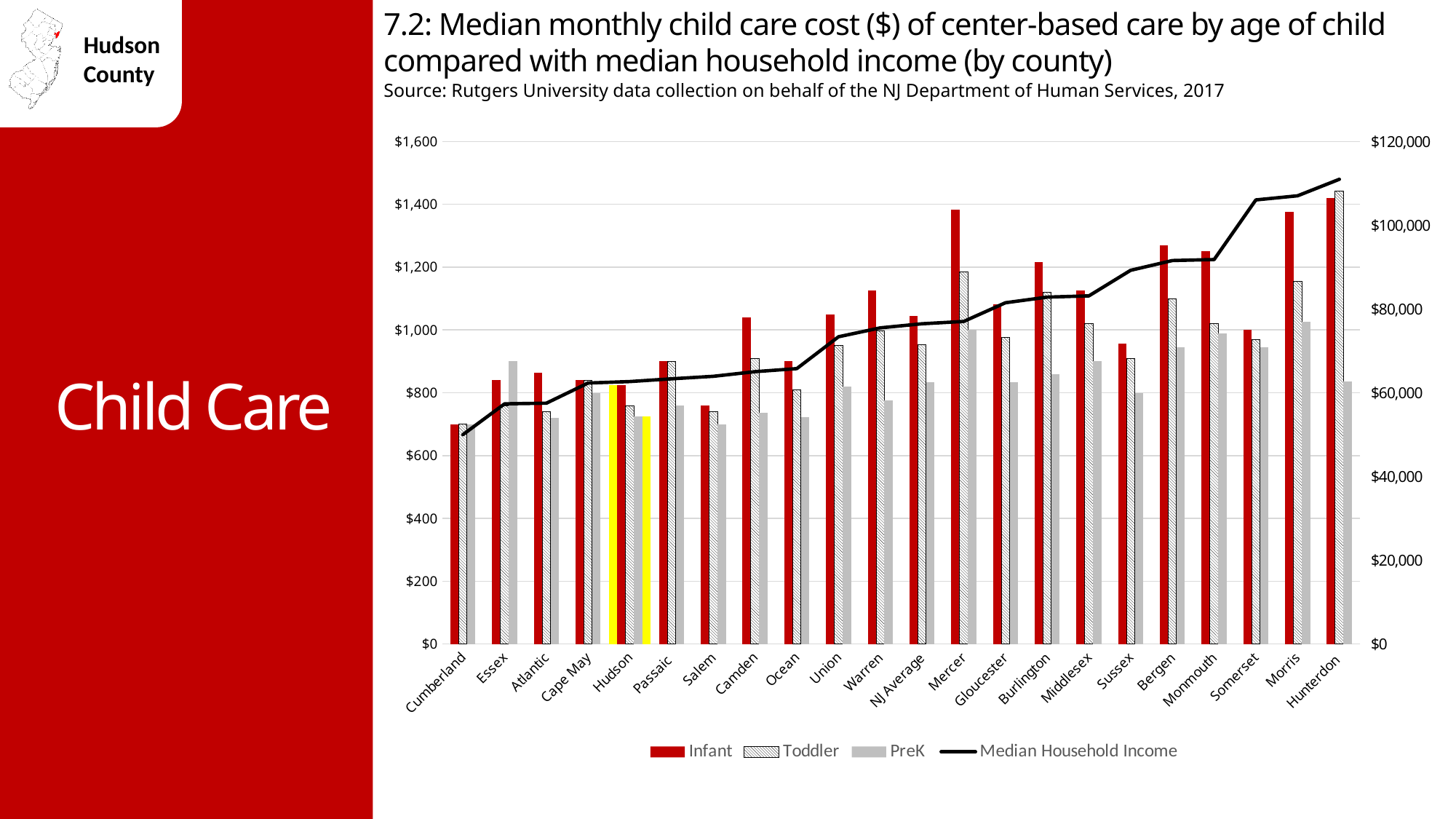
Which category has the highest Median Household Income? Hunterdon Which category has the highest Toddler cost? Hunterdon Is the Infant cost for Mercer greater or less than $1,200? greater Which category has the lowest Infant cost? Cumberland Is the PreK cost for Hudson greater or less than $800? less Does the Median Household Income line generally rise or fall from left to right across the x axis? rise Is the Median Household Income for Hunterdon greater or less than $100,000? greater Which is larger for Essex, the Infant cost or the PreK cost? PreK Which county's bars are highlighted in yellow? Hudson How many series does the legend list? 4 How many counties/categories are shown along the x axis? 22 What kind of chart is this? Bar chart with a line series